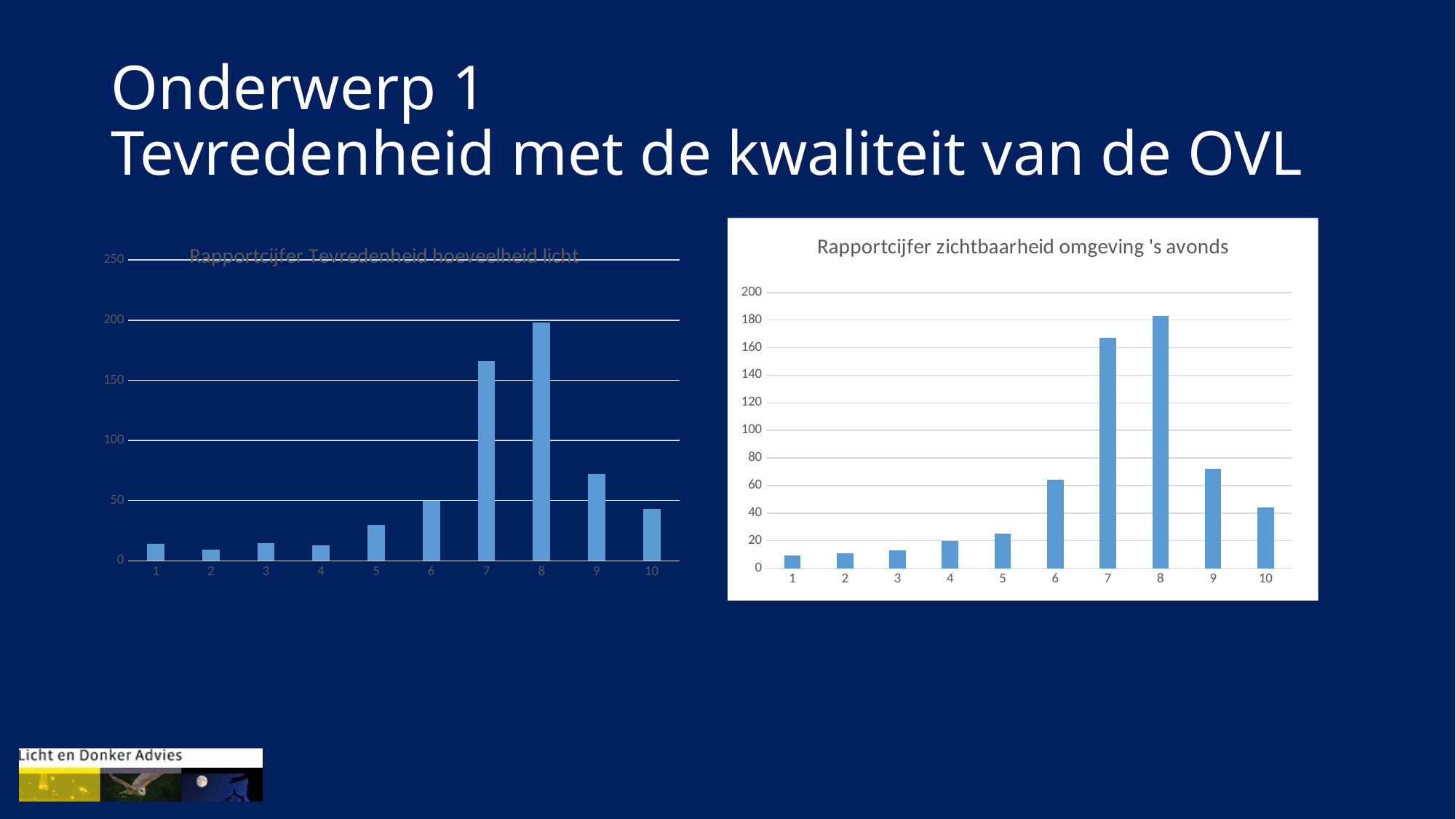
In the chart titled "Rapportcijfer zichtbaarheid omgeving 's avonds", which is larger, the value for 7 or the value for 9? 7 In the chart titled "Rapportcijfer Tevredenheid hoeveelheid licht", which category has the highest value? 8 In the chart titled "Rapportcijfer zichtbaarheid omgeving 's avonds", is the value for 10 greater or less than 40? greater In the chart titled "Rapportcijfer zichtbaarheid omgeving 's avonds", how many categories are shown on the x axis? 10 What kind of chart is the chart titled "Rapportcijfer zichtbaarheid omgeving 's avonds"? bar chart In the chart titled "Rapportcijfer Tevredenheid hoeveelheid licht", is the value for 7 greater or less than 150? greater What is the title of the chart on the right side of the slide? Rapportcijfer zichtbaarheid omgeving 's avonds In the chart titled "Rapportcijfer Tevredenheid hoeveelheid licht", is the value for 10 greater or less than 50? less In the chart titled "Rapportcijfer Tevredenheid hoeveelheid licht", which is larger, the value for 5 or the value for 9? 9 In the chart titled "Rapportcijfer zichtbaarheid omgeving 's avonds", which category has the highest value? 8